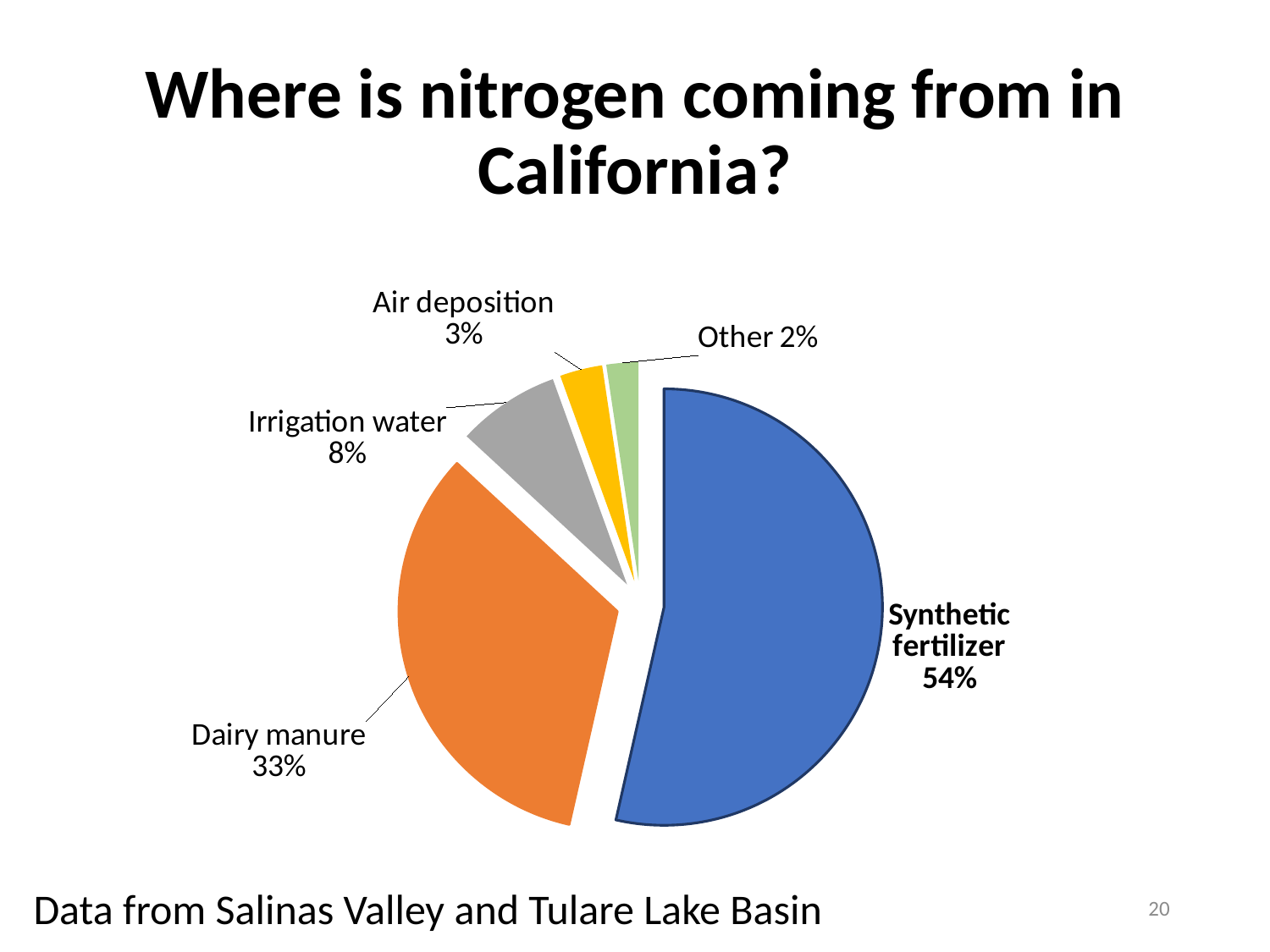
Which is larger, the share for irrigation water or the share for air deposition? Irrigation water What colour is the dairy manure slice? orange What share of nitrogen comes from dairy manure? 33% Which source accounts for the smallest share of nitrogen? Other How many slices does the pie chart have? 5 Which source accounts for the largest share of nitrogen? Synthetic fertilizer What share of nitrogen comes from synthetic fertilizer? 54% What share of nitrogen is labelled as Other? 2% How many percentage points larger is the synthetic fertilizer share than the dairy manure share? 21 What kind of chart is shown on the slide? pie chart What share of nitrogen comes from irrigation water? 8% What share of nitrogen comes from air deposition? 3%